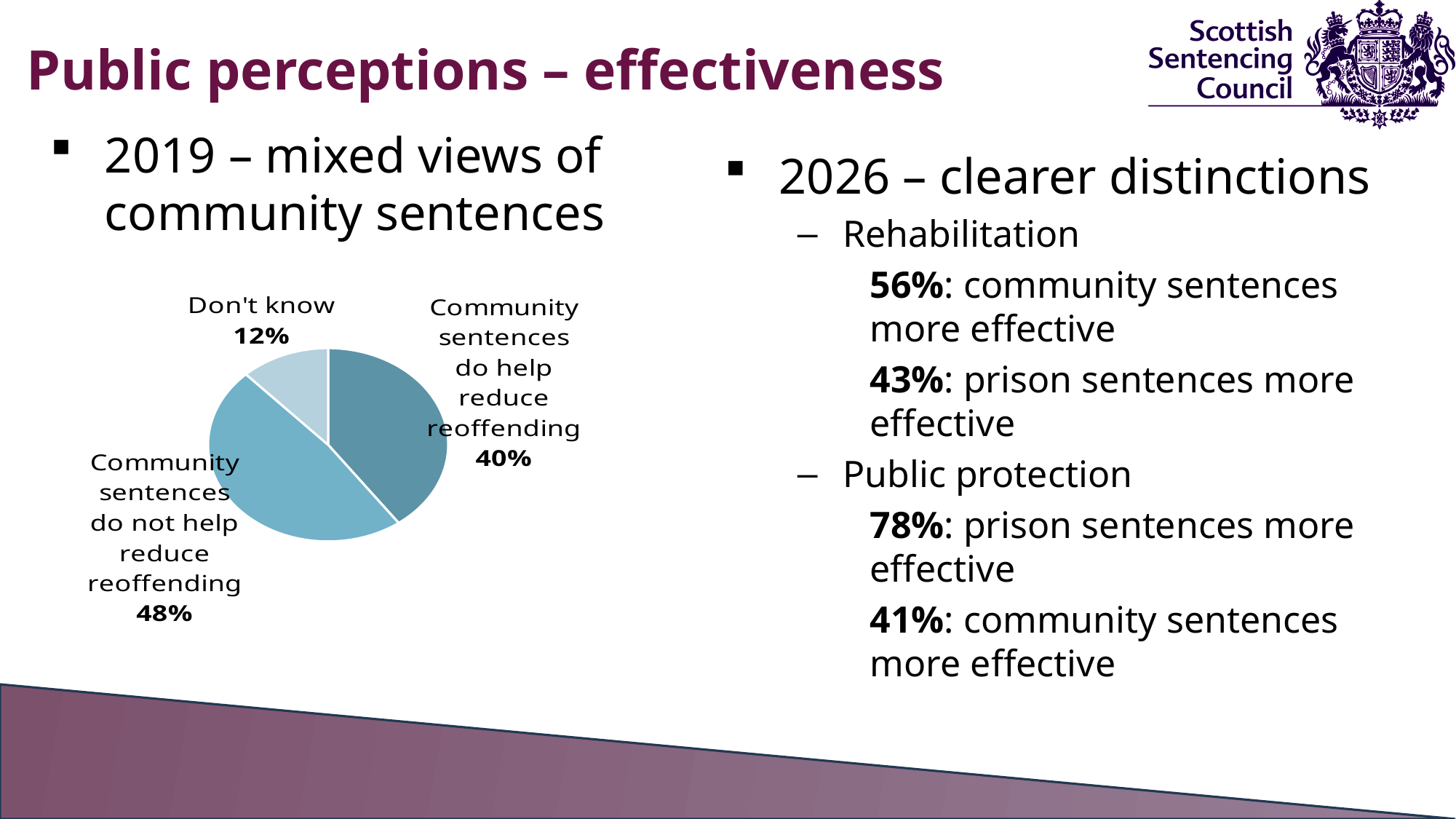
What percentage of the pie is labelled 'Community sentences do help reduce reoffending'? 40% How many slices does the pie chart have? 3 What kind of chart is shown on the slide? pie chart What percentage of the pie is labelled 'Community sentences do not help reduce reoffending'? 48% Which slice of the pie chart is shown in the lightest colour? Don't know Which slice of the pie chart is the largest? Community sentences do not help reduce reoffending What is the difference in percentage points between the 'do not help' slice and the 'do help' slice? 8 Which year does the pie chart's data relate to, according to the bullet above it? 2019 Which slice of the pie chart is the smallest? Don't know What percentage of the pie is labelled 'Don't know'? 12% Which is larger: the 'Community sentences do help reduce reoffending' slice or the 'Don't know' slice? Community sentences do help reduce reoffending What is the combined share of the two slices about whether community sentences help or do not help reduce reoffending? 88%